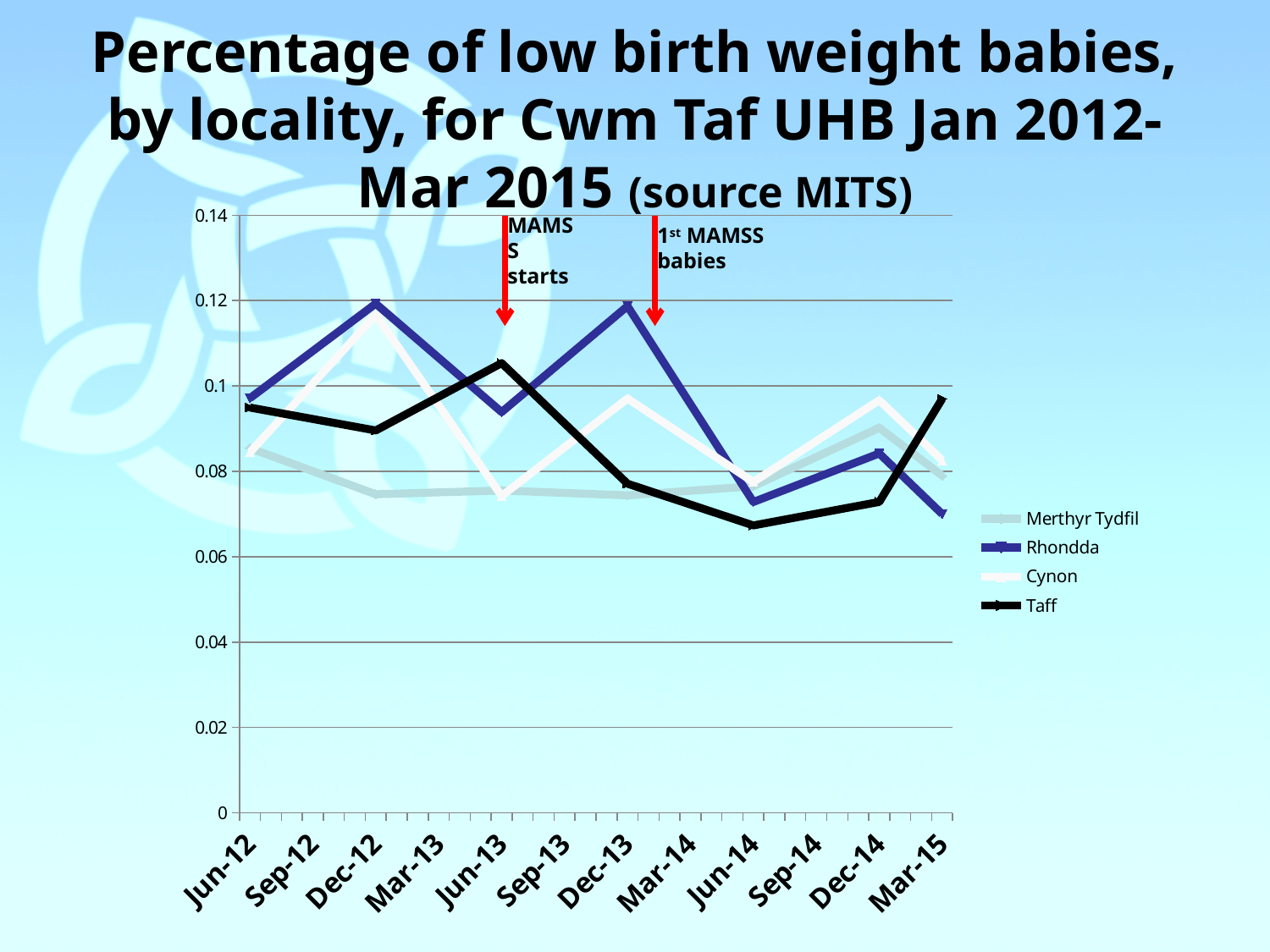
How many date labels are shown along the x axis? 12 Is the value for Rhondda at Mar-15 greater or less than 0.08? less Does the Taff line rise or fall between Jun-13 and Jun-14? fall Which locality has the highest value at Dec-13? Rhondda What kind of chart is shown on the slide? line chart At Mar-15, which is larger, the value for Taff or the value for Rhondda? Taff Is the value for Taff at Jun-14 greater or less than 0.08? less What event does the second red arrow on the chart mark? 1st MAMSS babies How many series does the legend list? 4 Which locality has the lowest value at Jun-14? Taff Is the value for Rhondda at Dec-12 greater or less than 0.1? greater